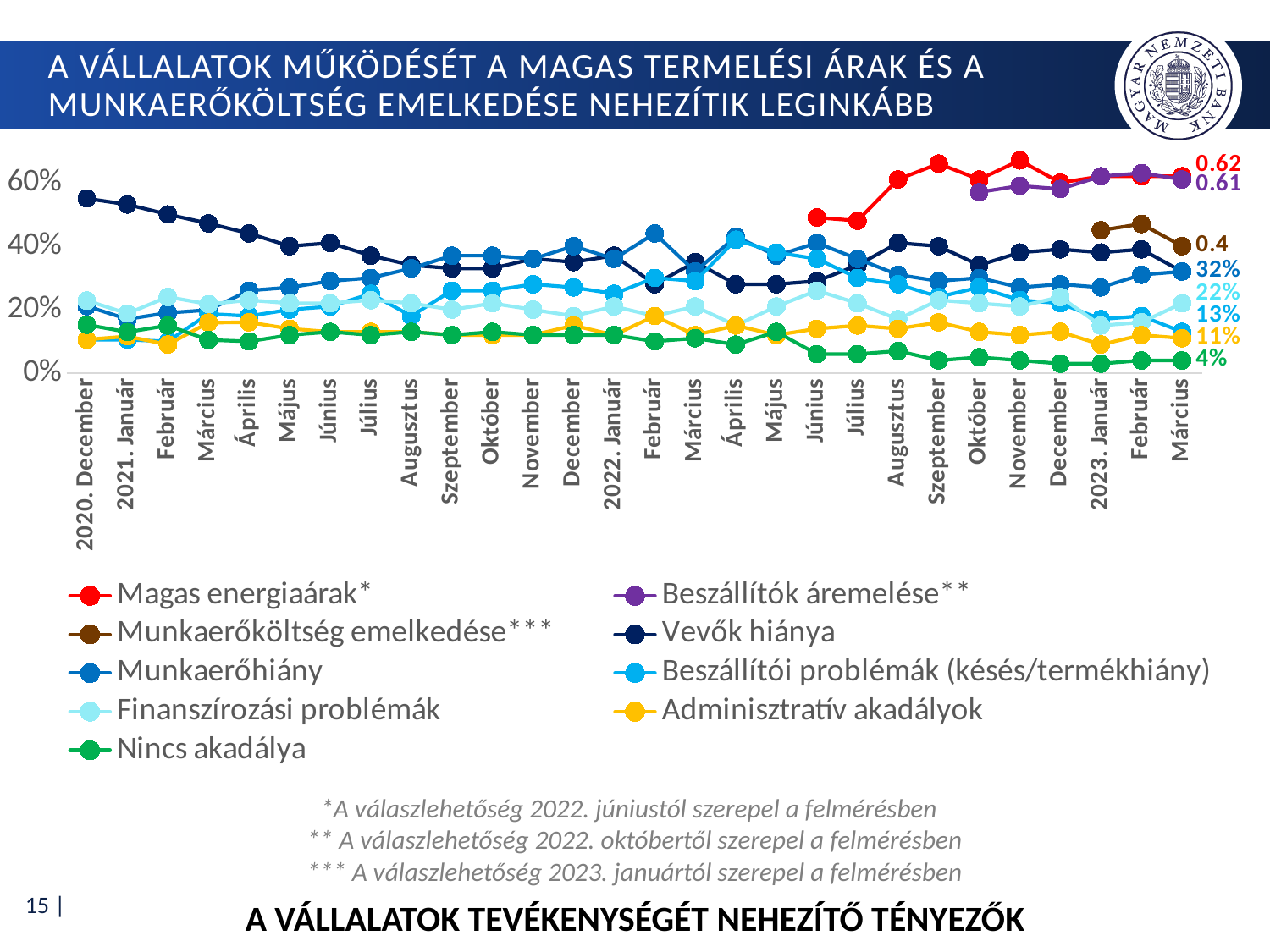
What is the value for Finanszírozási problémák in 2023 Március? 22% Is the value for Vevők hiánya in 2020 December greater or less than 40%? greater Which series has the highest value in 2023 Március? Magas energiaárak What is the value for Magas energiaárak in 2023 Március? 0.62 What type of chart is shown on the slide? line chart How many series does the legend list? 9 What is the value for Nincs akadálya in 2023 Március? 4% What is the difference between Finanszírozási problémák and Beszállítói problémák in 2023 Március? 9% What is the value for Adminisztratív akadályok in 2023 Március? 11% What is the value for Beszállítók áremelése in 2023 Március? 0.61 Does the Vevők hiánya series rise or fall from 2020 December to 2023 Március? fall What is the value for Munkaerőköltség emelkedése in 2023 Március? 0.4